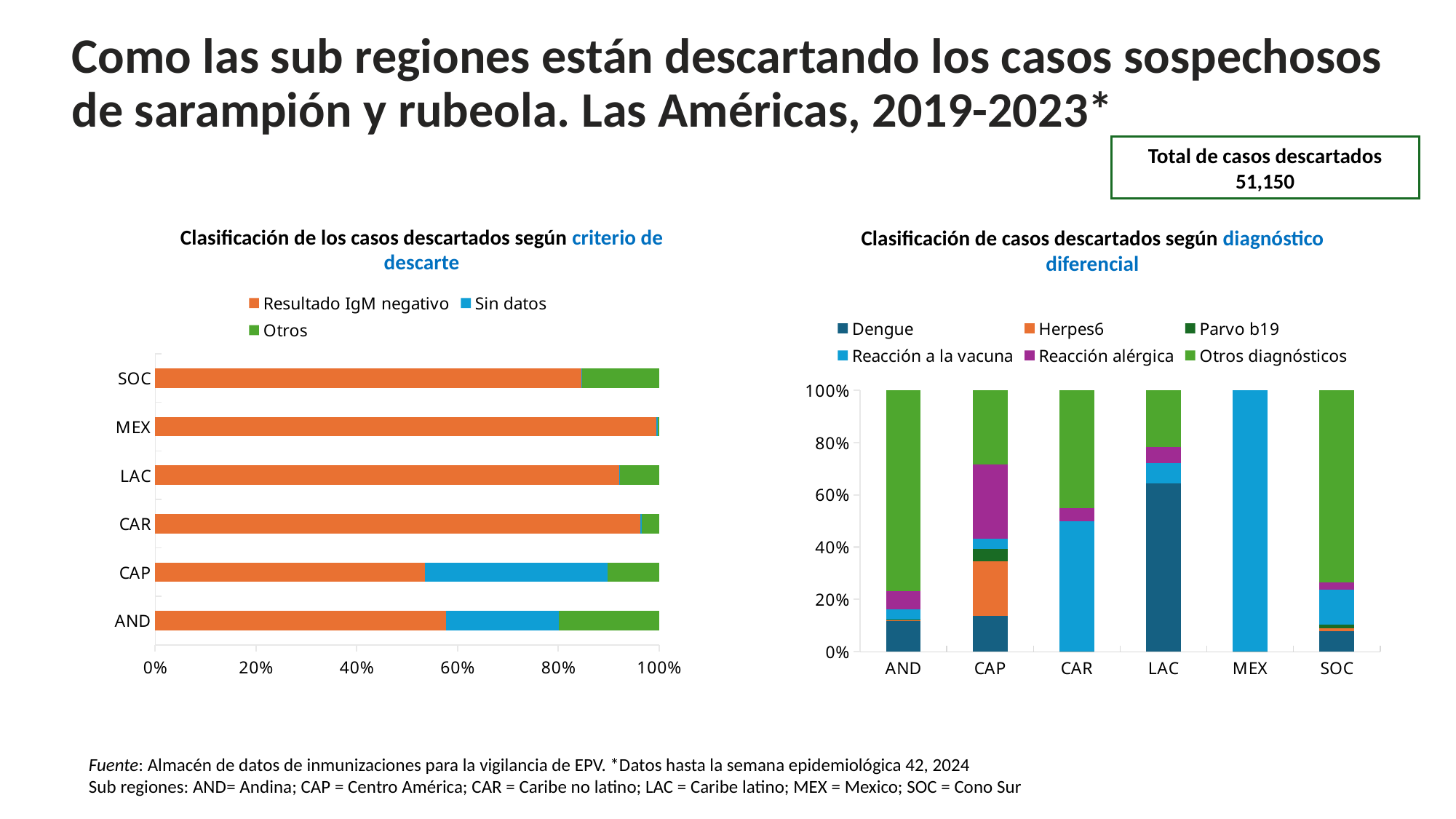
On the right chart, 'Clasificación de casos descartados según diagnóstico diferencial', which series is shown in orange? Herpes6 How many series does the legend of the right chart, 'Clasificación de casos descartados según diagnóstico diferencial', list? 6 On the left chart, 'Clasificación de los casos descartados según criterio de descarte', which sub region has the largest 'Sin datos' share? CAP How many series does the legend of the left chart, 'Clasificación de los casos descartados según criterio de descarte', list? 3 On the right chart, 'Clasificación de casos descartados según diagnóstico diferencial', is the 'Reacción a la vacuna' share for CAR greater or less than 40%? greater What kind of chart is the left chart, 'Clasificación de los casos descartados según criterio de descarte'? Stacked bar chart On the left chart, 'Clasificación de los casos descartados según criterio de descarte', is the 'Resultado IgM negativo' share for CAP greater or less than 60%? less On the right chart, 'Clasificación de casos descartados según diagnóstico diferencial', which sub region has the largest 'Dengue' share? LAC On the left chart, 'Clasificación de los casos descartados según criterio de descarte', is the 'Sin datos' share for CAP greater or less than 20%? greater On the left chart, 'Clasificación de los casos descartados según criterio de descarte', which is larger, the 'Otros' share for AND or for CAR? AND On the right chart, 'Clasificación de casos descartados según diagnóstico diferencial', which is larger, the 'Otros diagnósticos' share for AND or for LAC? AND How many sub regions are shown on the left chart, 'Clasificación de los casos descartados según criterio de descarte'? 6